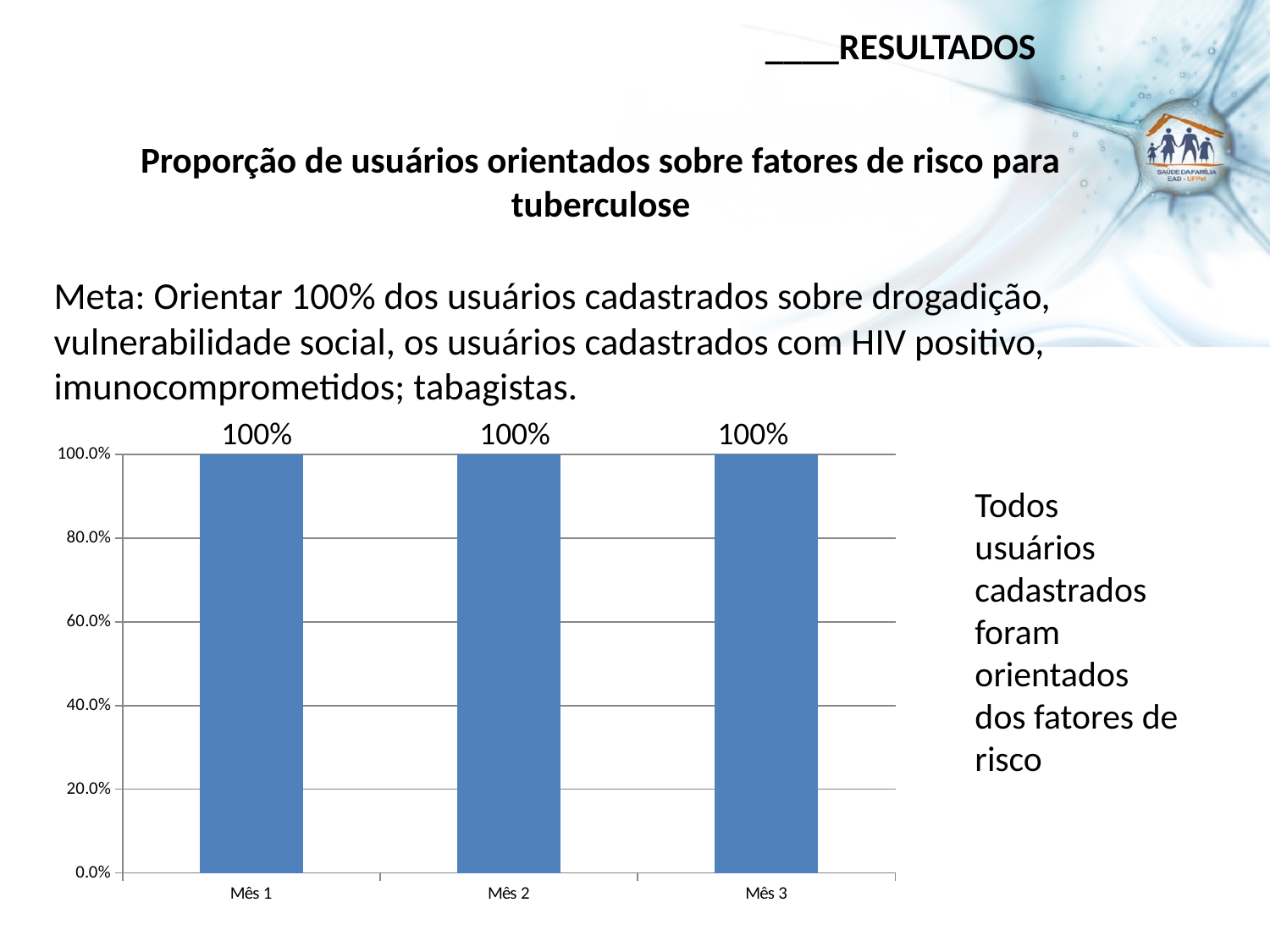
What is the value for Mês 2? 100% What is the value for Mês 3? 100% What is the highest value shown on the y axis of the chart? 100.0% Do the values rise, fall or stay the same from Mês 1 to Mês 3? Stay the same What is the difference between the values for Mês 1 and Mês 3? 0% What kind of chart is shown on the slide? Bar chart Is the value for Mês 1 greater or less than 80.0%? greater What is the title of the chart on the slide? Proporção de usuários orientados sobre fatores de risco para tuberculose How many categories are shown on the x axis of the chart? 3 Is the value for Mês 2 larger than, smaller than or equal to the value for Mês 3? Equal What is the value for Mês 1? 100%